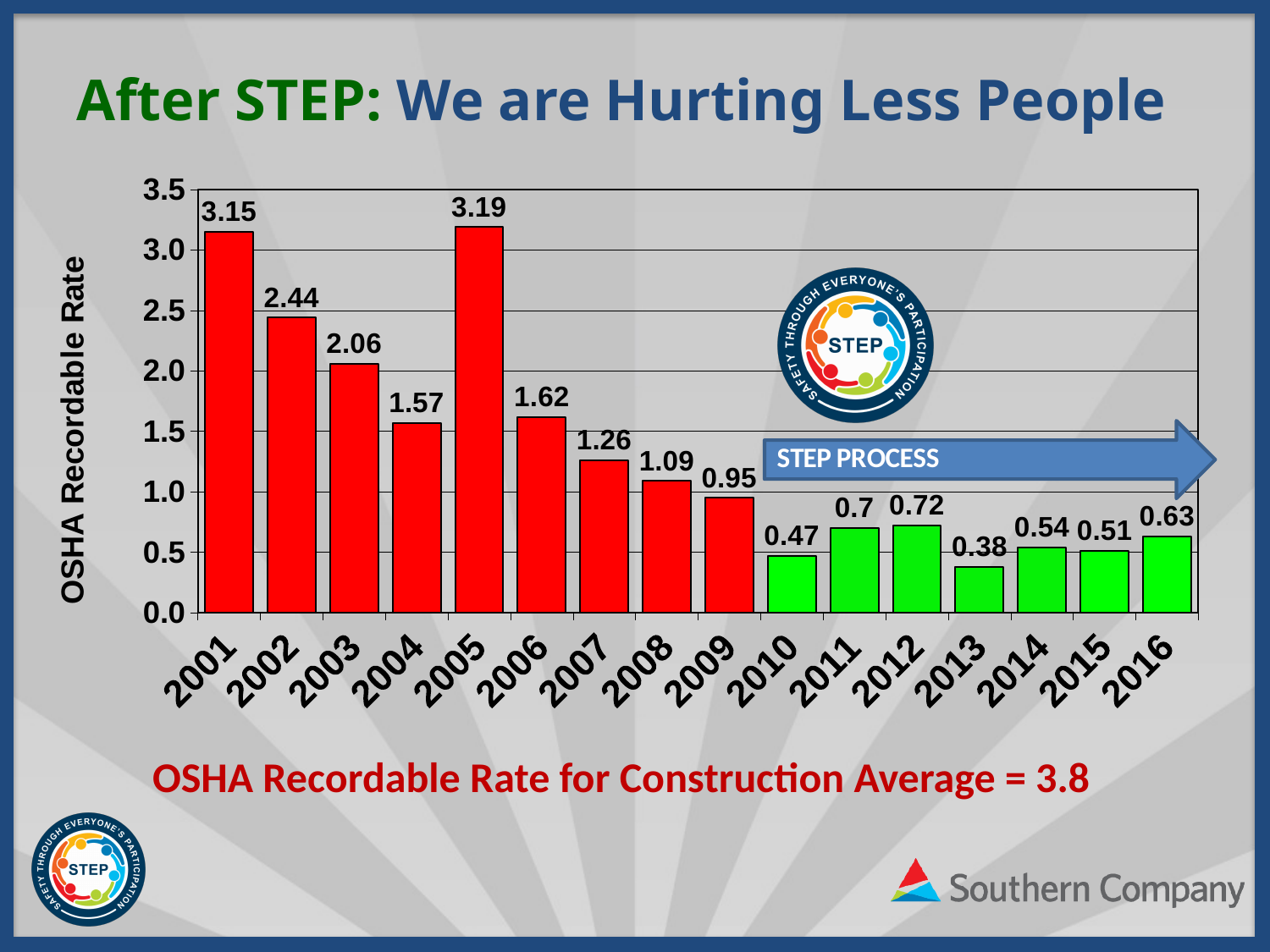
Which year has a higher OSHA Recordable Rate, 2004 or 2006? 2006 What is the label on the y axis of the chart? OSHA Recordable Rate Which year has the lowest OSHA Recordable Rate? 2013 What is the OSHA Recordable Rate for 2005? 3.19 What is the difference between the OSHA Recordable Rate in 2001 and in 2016? 2.52 Is the value for 2009 greater or less than 1.0? less What is the OSHA Recordable Rate for 2010? 0.47 Which year has the highest OSHA Recordable Rate? 2005 How many years are shown on the x axis of the chart? 16 What is the OSHA Recordable Rate for 2013? 0.38 What kind of chart is shown on the slide? bar chart Do the OSHA Recordable Rate values generally rise or fall from 2001 to 2016? fall